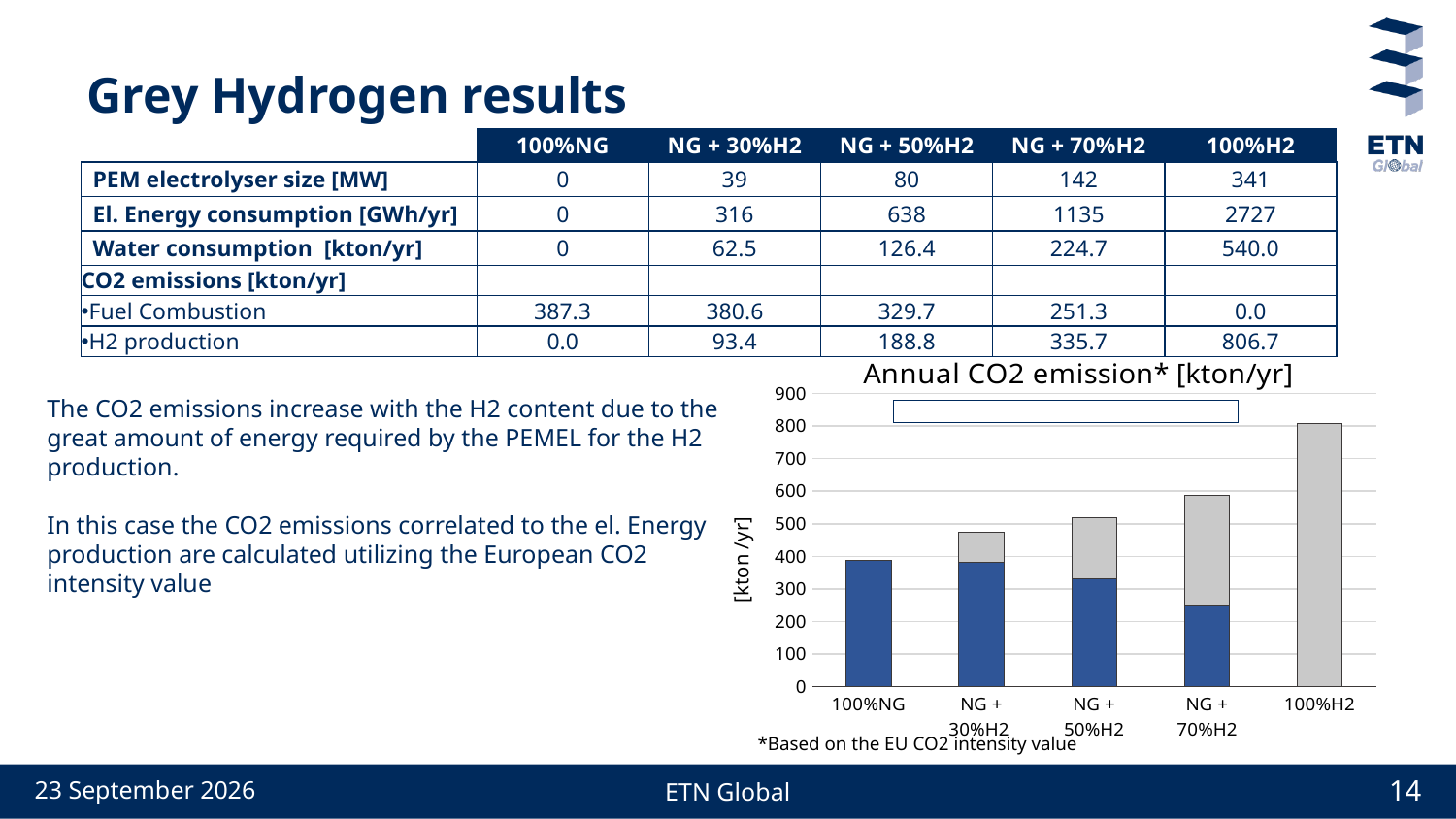
Which category has the lowest total bar in the Annual CO2 emission chart? 100%NG Is the total bar for NG + 50%H2 greater or less than 600? less Is the total bar for 100%NG greater or less than 500? less Is the total bar for NG + 70%H2 greater or less than 500? greater Which has the larger total bar, 100%NG or NG + 70%H2? NG + 70%H2 What kind of chart is shown on the slide? bar chart Which has the larger blue (bottom) segment, 100%NG or NG + 70%H2? 100%NG How many categories are shown on the x axis of the Annual CO2 emission chart? 5 Which category has the highest total bar in the Annual CO2 emission chart? 100%H2 What is the title of the chart? Annual CO2 emission* [kton/yr] Do the total bar heights rise or fall from 100%NG to 100%H2 along the x axis? rise